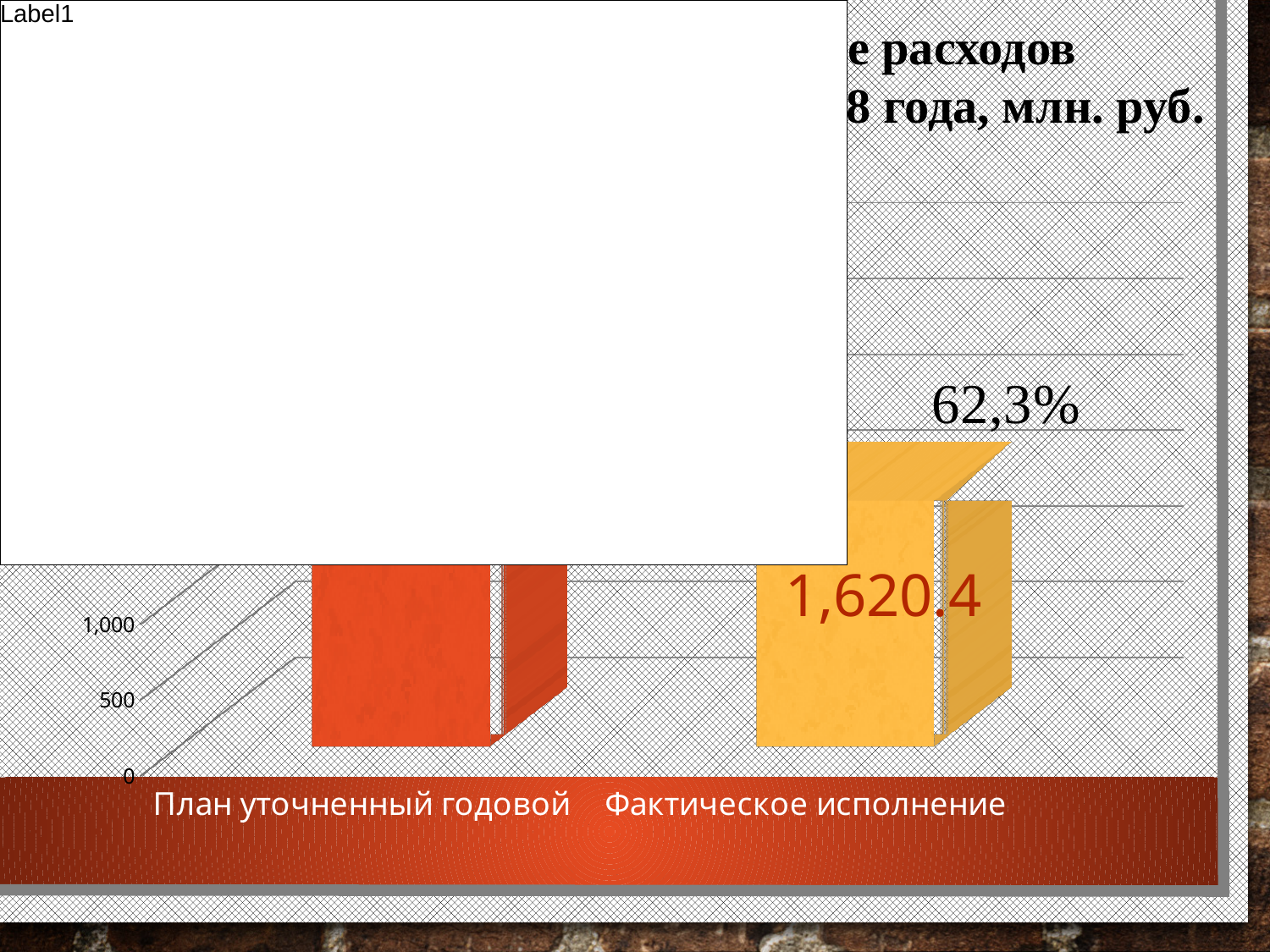
How many categories are shown on the x axis of the chart? 2 Is the value for План уточненный годовой greater or less than 500? greater Is the value for План уточненный годовой greater or less than 1,000? greater What colour is the bar for Фактическое исполнение? yellow What percentage is printed above the Фактическое исполнение bar? 62,3% What kind of chart is shown on the slide? bar chart What is the value for Фактическое исполнение? 1,620.4 Is the value for Фактическое исполнение greater or less than 1,000? greater